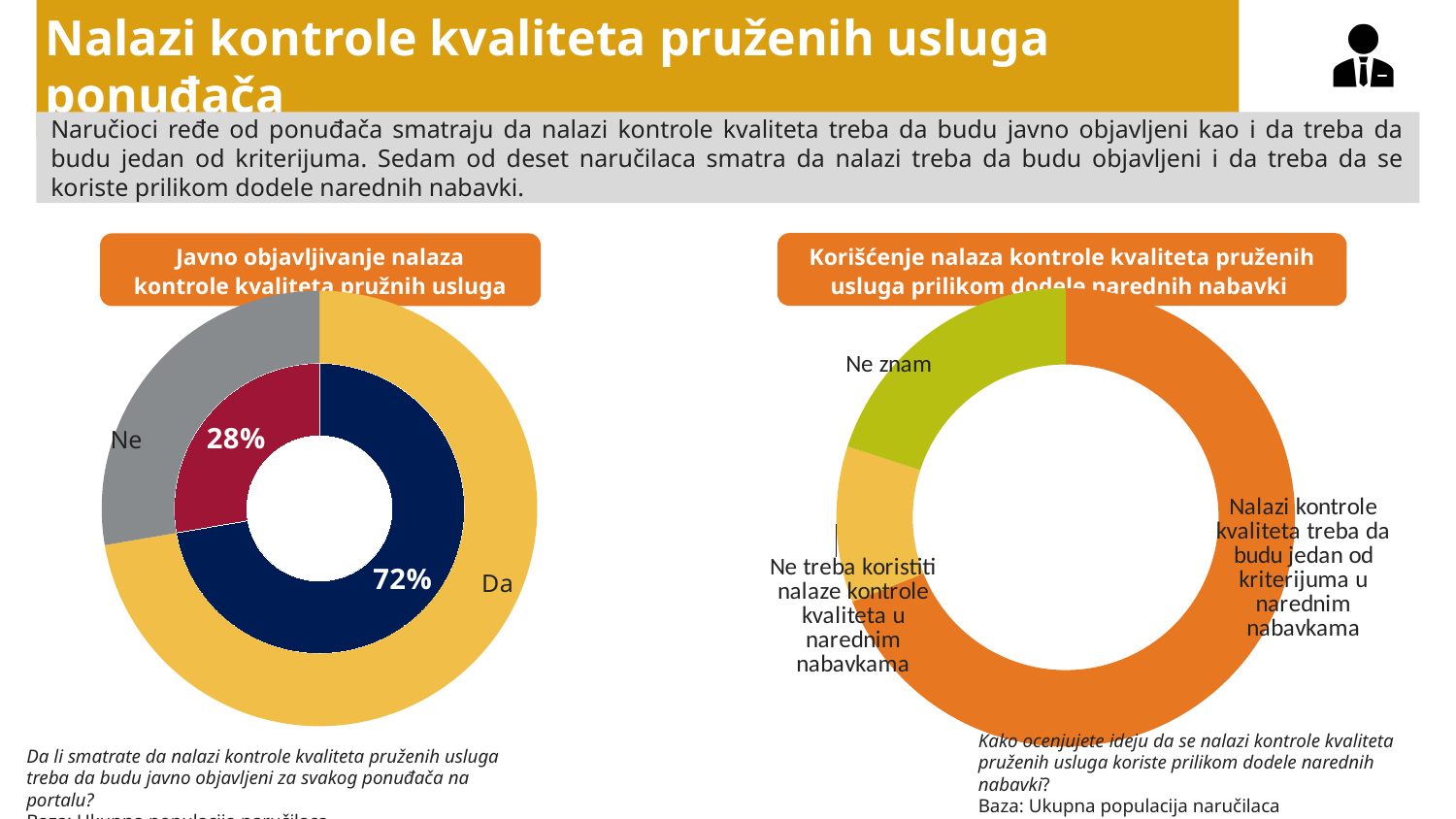
In the right chart, what colour is the "Ne znam" slice? Green In the left chart, which category has the lowest value? Ne In the left chart, what is the difference in percentage points between "Da" and "Ne"? 44 What type of chart is used on the left side of the slide? Doughnut chart In the chart titled "Javno objavljivanje nalaza kontrole kvaliteta pružnih usluga", what percentage is shown for "Da"? 72% In the chart titled "Javno objavljivanje nalaza kontrole kvaliteta pružnih usluga", what percentage is shown for "Ne"? 28% In the left chart, which category has the larger share, "Da" or "Ne"? Da What is the title of the chart on the left side of the slide? Javno objavljivanje nalaza kontrole kvaliteta pružnih usluga In the right chart, which category takes up the largest share? Nalazi kontrole kvaliteta treba da budu jedan od kriterijuma u narednim nabavkama What type of chart is used on the right side of the slide? Doughnut chart In the left chart, which category has the highest value? Da How many categories are shown in the chart titled "Korišćenje nalaza kontrole kvaliteta pruženih usluga prilikom dodele narednih nabavki"? 3